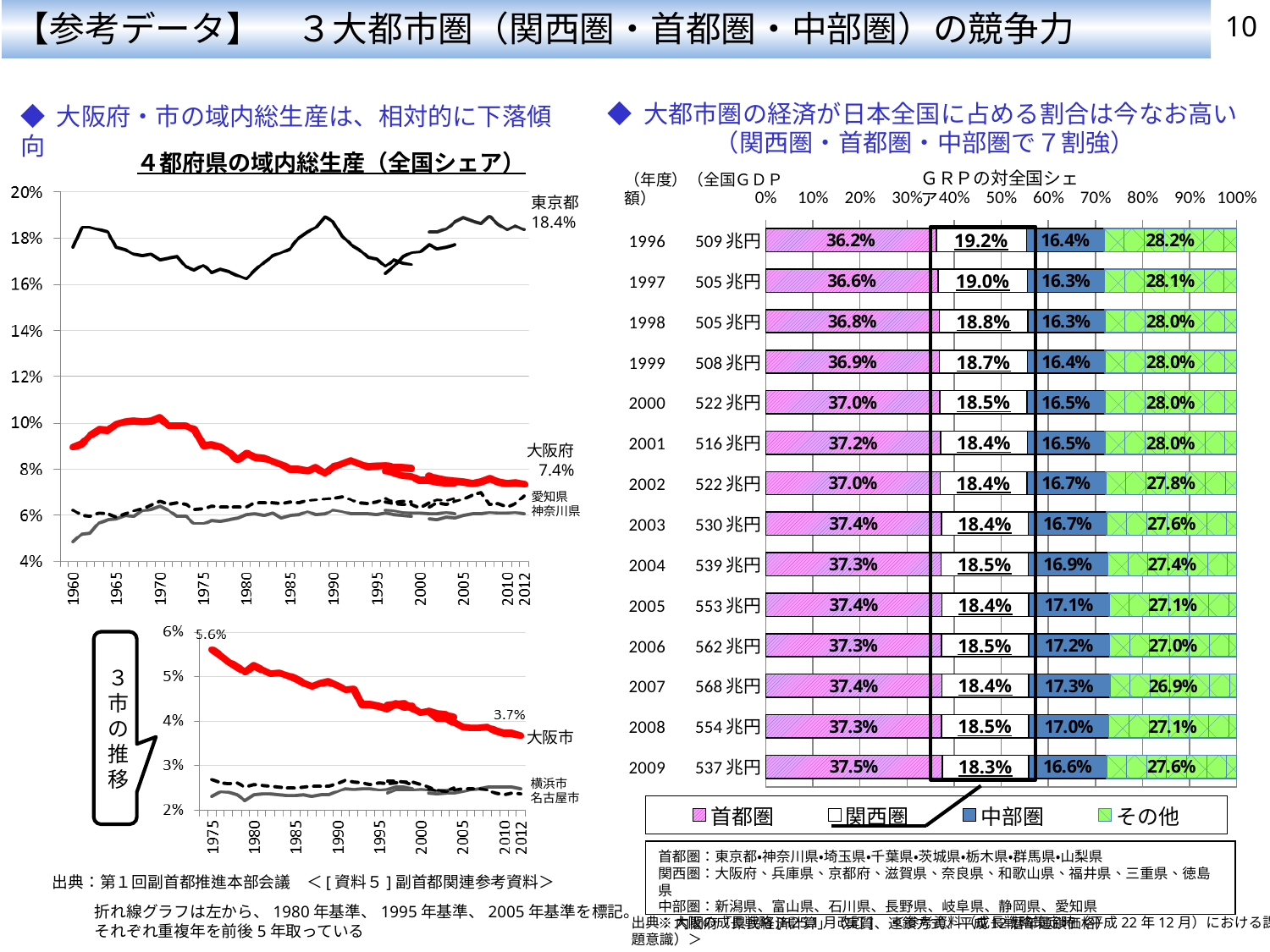
In the right-hand chart 'ＧＲＰの対全国シェア', which year has the lowest share for 関西圏? 2009 In the right-hand chart 'ＧＲＰの対全国シェア', what is the share of 首都圏 in 2009? 37.5% What kind of chart is the right-hand chart titled 'ＧＲＰの対全国シェア'? bar chart In the right-hand chart 'ＧＲＰの対全国シェア', which year has the highest share for 首都圏? 2009 How many series does the legend of the right-hand chart 'ＧＲＰの対全国シェア' list? 4 In the top-left chart '４都府県の域内総生産（全国シェア）', what is the labelled value for 東京都 at the end of the series? 18.4% In the bottom-left chart '３市の推移', what is the difference between the 大阪市 value in 1975 (5.6%) and in 2012 (3.7%)? 1.9 percentage points In the right-hand chart 'ＧＲＰの対全国シェア', in 2009 which is larger, the share of 関西圏 or the share of 中部圏? 関西圏 In the top-left chart '４都府県の域内総生産（全国シェア）', is the value for 大阪府 in 1965 greater or less than 8%? greater In the right-hand chart 'ＧＲＰの対全国シェア', by how many percentage points did the 関西圏 share fall from 1996 to 2009? 0.9 percentage points In the right-hand chart 'ＧＲＰの対全国シェア', what is the share of 関西圏 in 1996? 19.2% How many years (bars) are shown in the right-hand chart 'ＧＲＰの対全国シェア'? 14